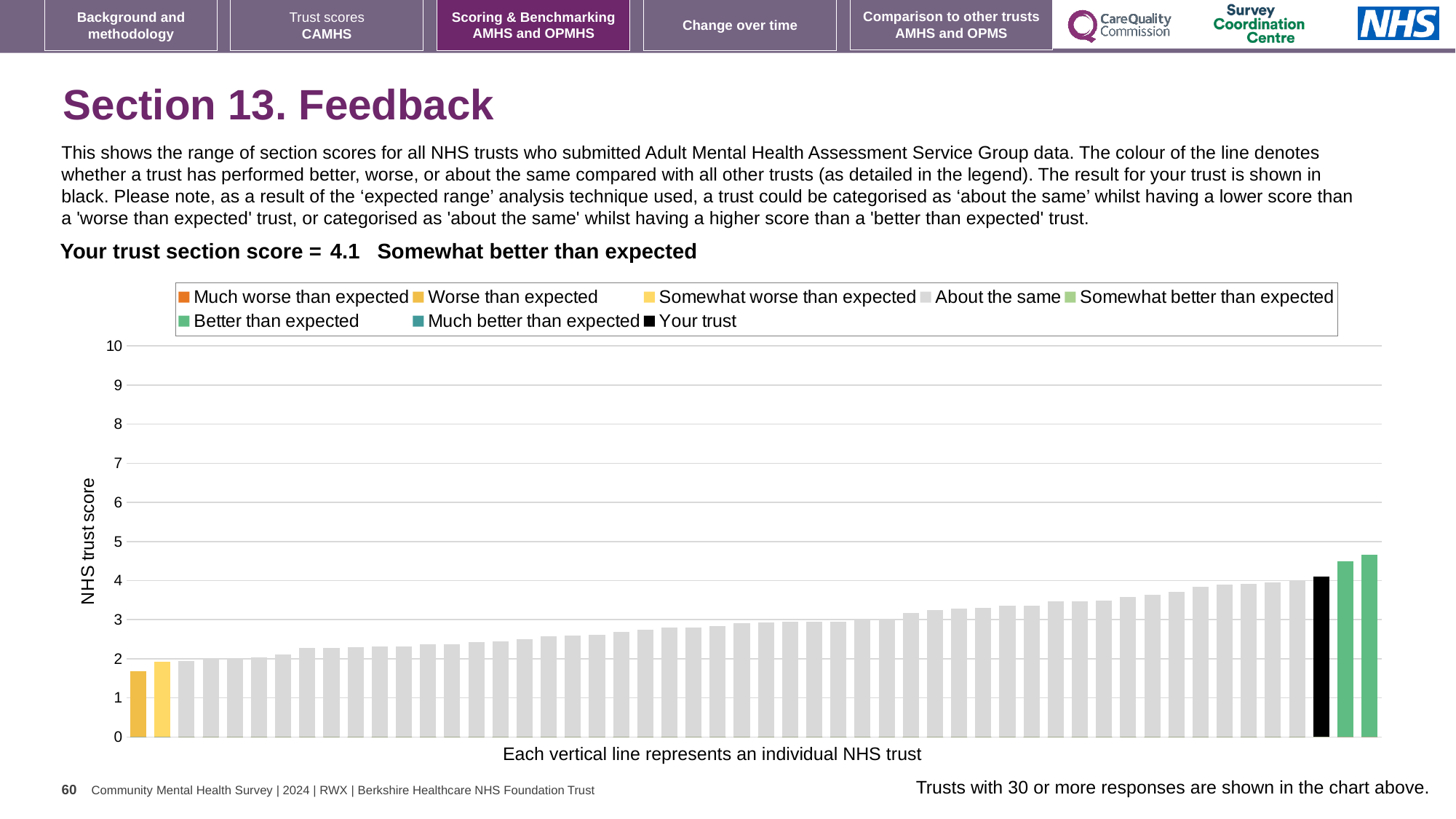
Is the value of the leftmost (lowest) bar greater or less than 2? less How many entries does the chart legend list? 8 What is the label on the vertical axis of the chart? NHS trust score Is the value of the black 'Your trust' bar greater or less than 4? greater What kind of chart is shown on the slide? bar chart Do the bar values rise or fall from left to right along the x axis? rise Which is larger: the black 'Your trust' bar or the tallest grey 'About the same' bar? the black 'Your trust' bar What is the highest value shown on the vertical axis? 10 How many bars are coloured green (Better than expected) in the chart? 2 Is the value of the rightmost (highest) bar greater or less than 5? less What is the section score for your trust shown on the slide? 4.1 What colour is the bar representing your trust? black